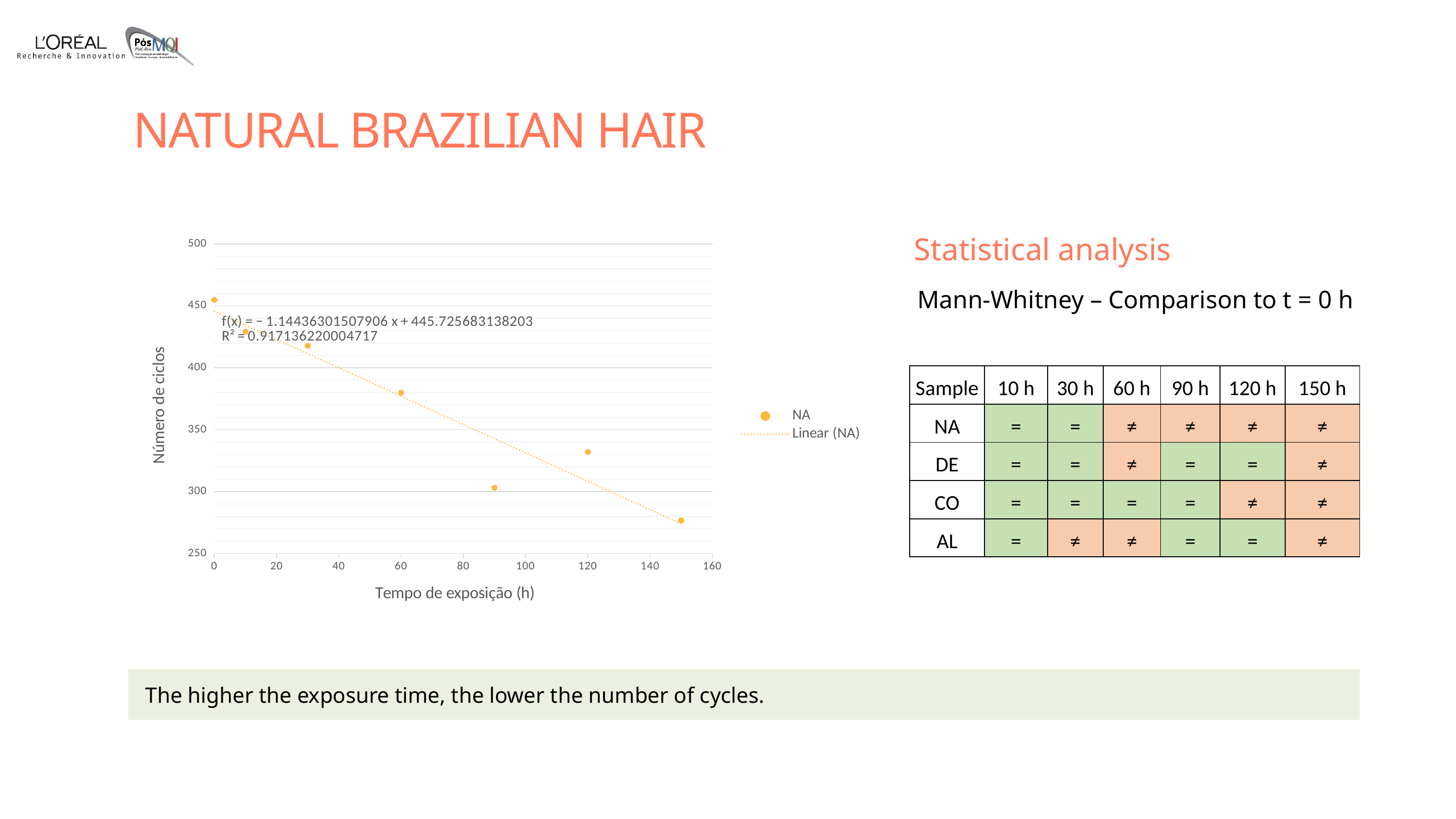
Do the number of cycles rise or fall as exposure time increases? Fall At which exposure time is the number of cycles highest? 0 h Is the number of cycles at 150 h of exposure greater or less than 300? less Is the number of cycles at 60 h of exposure greater or less than 400? less What is the title of the chart's x axis? Tempo de exposição (h) How many entries does the chart legend list? 2 At which exposure time is the number of cycles lowest? 150 h Is the number of cycles at 30 h of exposure greater or less than 400? greater What kind of chart is shown on the slide? Scatter chart How many data points are plotted in the NA series? 7 Which has more cycles: the point at 90 h or the point at 120 h? 120 h What R² value is printed on the chart for the linear trendline? 0.917136220004717